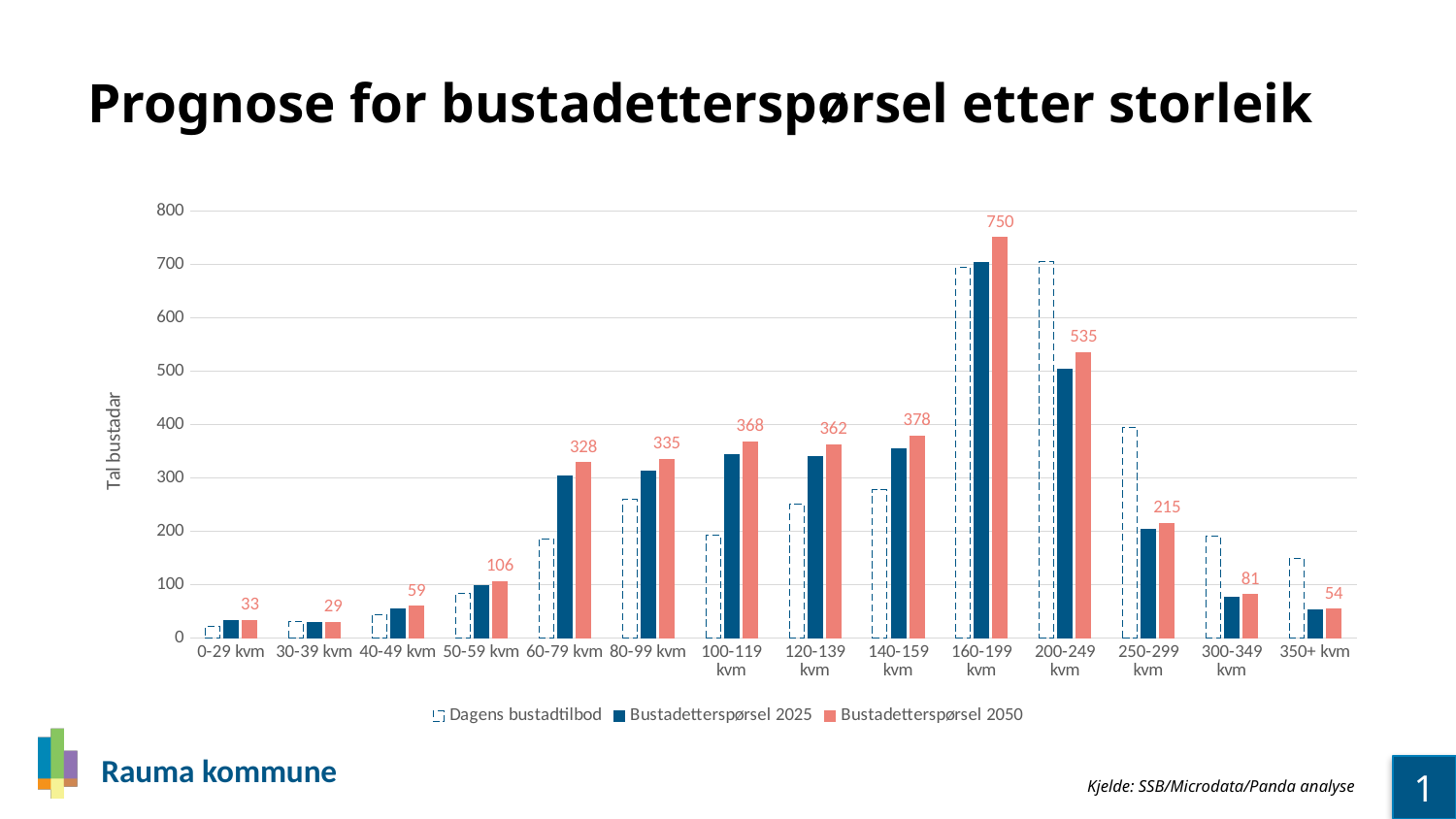
How many size categories are shown on the x axis? 14 What is the difference between the Bustadetterspørsel 2050 values for 160-199 kvm and 200-249 kvm? 215 What is the Bustadetterspørsel 2050 value for 160-199 kvm? 750 What is the Bustadetterspørsel 2050 value for 350+ kvm? 54 What is the Bustadetterspørsel 2050 value for 60-79 kvm? 328 Which size category has the lowest Bustadetterspørsel 2050 value? 30-39 kvm Which size category has the highest Bustadetterspørsel 2050 value? 160-199 kvm Is the Bustadetterspørsel 2025 value for 200-249 kvm greater or less than 400? greater Which is larger for Bustadetterspørsel 2050: 120-139 kvm or 140-159 kvm? 140-159 kvm What kind of chart is shown on the slide? Bar chart How many series does the legend list? 3 Is the Dagens bustadtilbod value for 100-119 kvm greater or less than 300? less